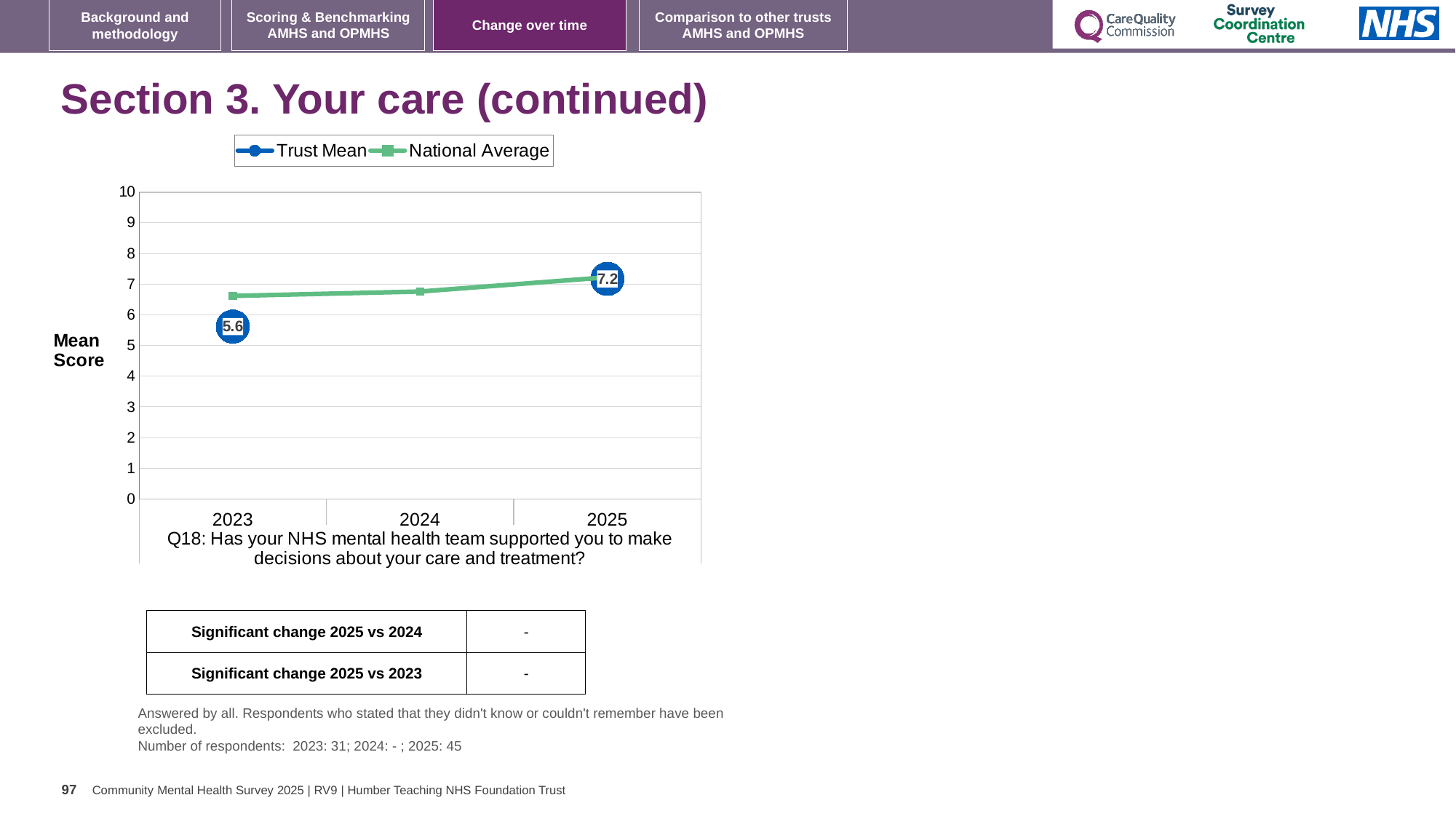
In which year is the Trust Mean score highest? 2025 What kind of chart is shown on the slide? Line chart Is the National Average value for 2024 greater or less than 7? less How many years are shown on the x axis? 3 In which year is the Trust Mean score lowest? 2023 In 2023, which is larger: the Trust Mean or the National Average? National Average Does the Trust Mean score rise or fall from 2023 to 2025? Rise How many series does the legend list? 2 What is the Trust Mean score for 2023? 5.6 Is the National Average value for 2023 greater or less than 6? greater What is the difference between the Trust Mean score in 2025 and in 2023? 1.6 What is the Trust Mean score for 2025? 7.2